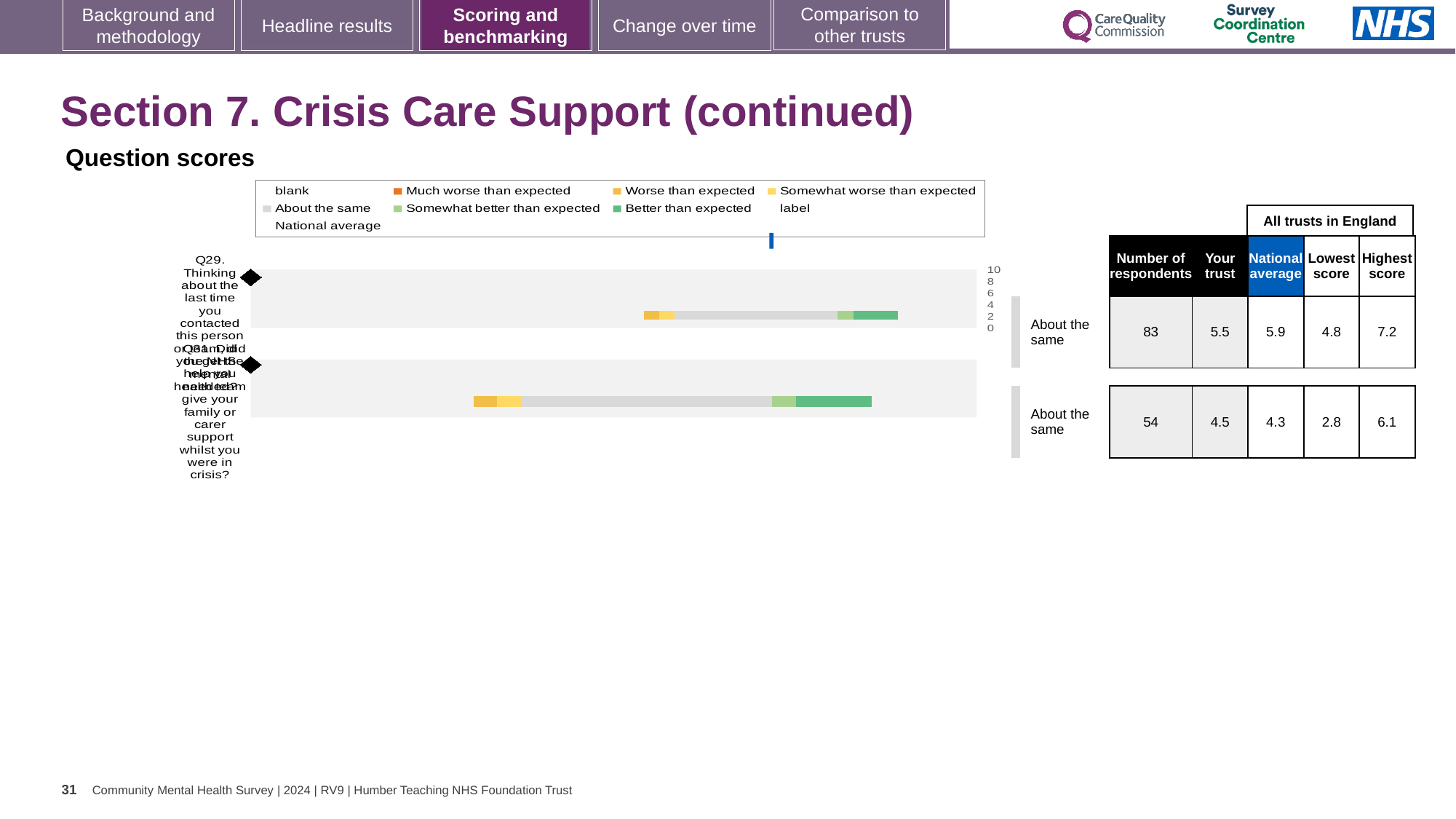
Which question has the higher 'Your trust' score, Q29 or Q31? Q29 How many question bars are plotted in the chart? 2 What kind of chart is shown under 'Question scores'? Bar chart What benchmark category is given for Q29 ('About the same', 'Better than expected', etc.)? About the same What is the lowest score among all trusts in England for Q29? 4.8 What is the highest score among all trusts in England for Q31? 6.1 What is the difference between the highest and lowest scores for Q31? 3.3 What is the national average for Q29? 5.9 Which legend entry is shown in light grey? About the same Which legend entry is shown in orange? Much worse than expected What is the 'Your trust' score for Q31? 4.5 What is the number of respondents for Q29? 83